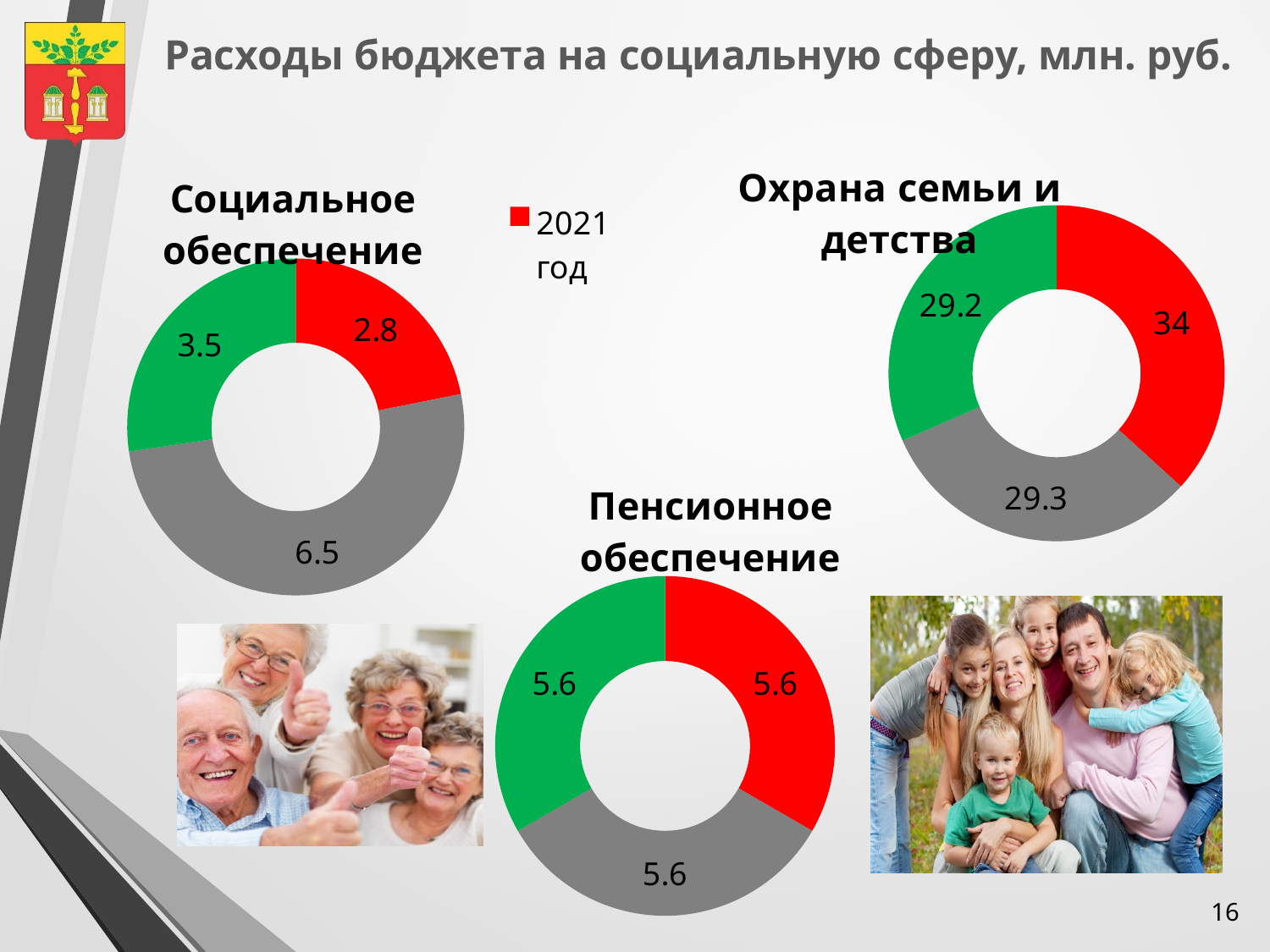
Which year is shown in the legend, and what colour represents it? 2021 год, red In the "Пенсионное обеспечение" chart, what is the value of each slice? 5.6 In the "Охрана семьи и детства" chart, what is the value for 2021 год (the red slice)? 34 In the "Охрана семьи и детства" chart, which is larger: the red slice or the grey slice? the red slice (34) In the "Социальное обеспечение" chart, what is the difference between the grey slice and the 2021 год slice? 3.7 What kind of chart is used for "Социальное обеспечение"? doughnut chart How many slices does the "Пенсионное обеспечение" chart have? 3 In the "Социальное обеспечение" chart, what is the value for 2021 год (the red slice)? 2.8 In the "Социальное обеспечение" chart, which slice is the largest? the grey slice (6.5) In the "Социальное обеспечение" chart, what is the value of the grey slice? 6.5 In the "Охрана семьи и детства" chart, what is the value of the green slice? 29.2 In the "Охрана семьи и детства" chart, what is the difference between the red slice and the grey slice? 4.7